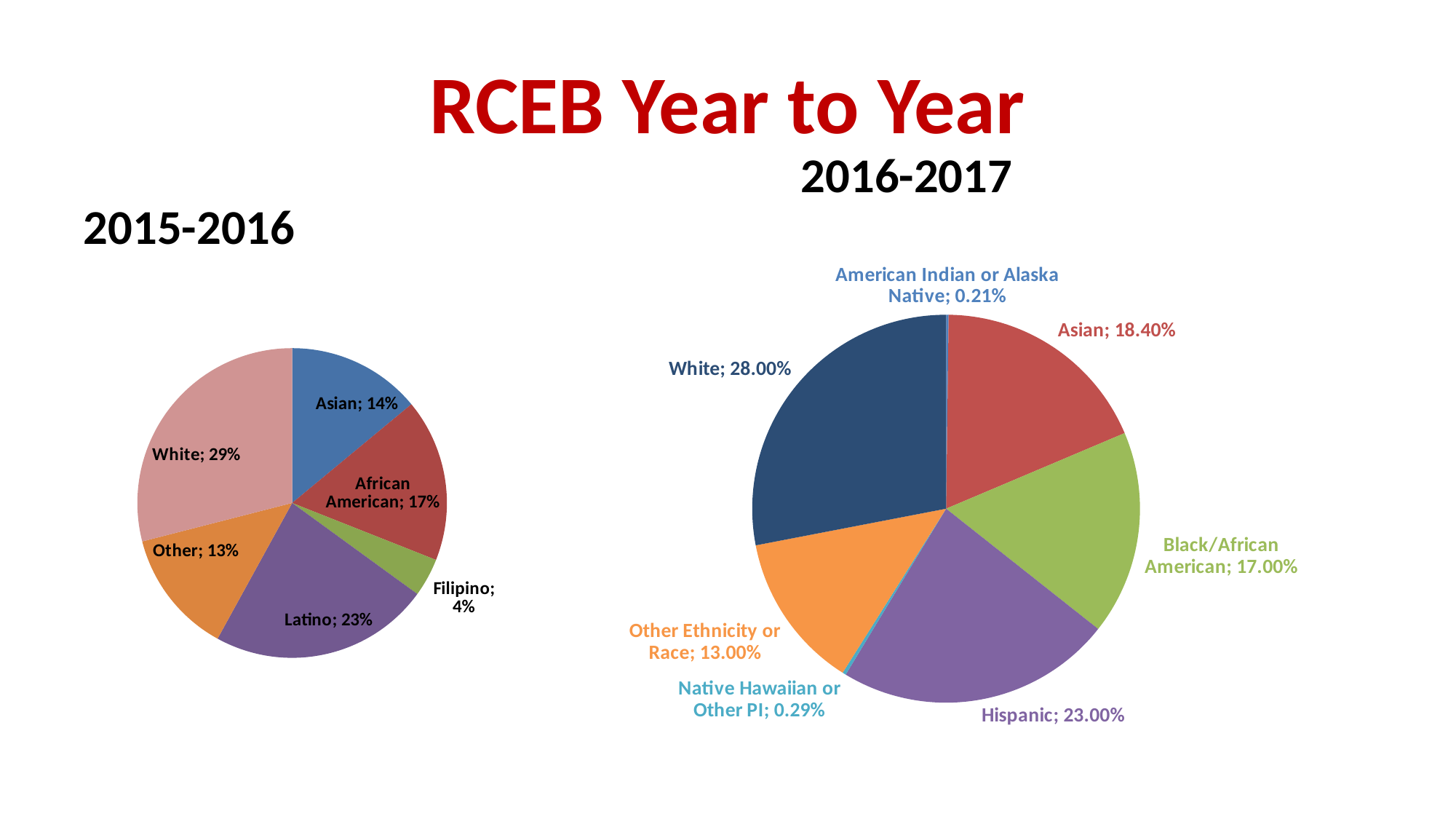
In the 2015-2016 pie chart, what is the difference between the Asian and Other shares? 1% In the 2016-2017 pie chart, what share is labelled for Asian? 18.40% What type of chart is used for the 2016-2017 data? Pie chart In the 2015-2016 pie chart, which category has the largest slice? White In the 2015-2016 pie chart, what share is labelled for Latino? 23% In the 2015-2016 pie chart, which category has the smallest slice? Filipino In the 2015-2016 pie chart, what share is labelled for White? 29% In the 2016-2017 pie chart, how many slices are there? 7 In the 2016-2017 pie chart, what share is labelled for American Indian or Alaska Native? 0.21% In the 2015-2016 pie chart, how many slices are there? 6 In the 2016-2017 pie chart, which is larger, Hispanic or Black/African American? Hispanic In the 2016-2017 pie chart, which category has the largest slice? White